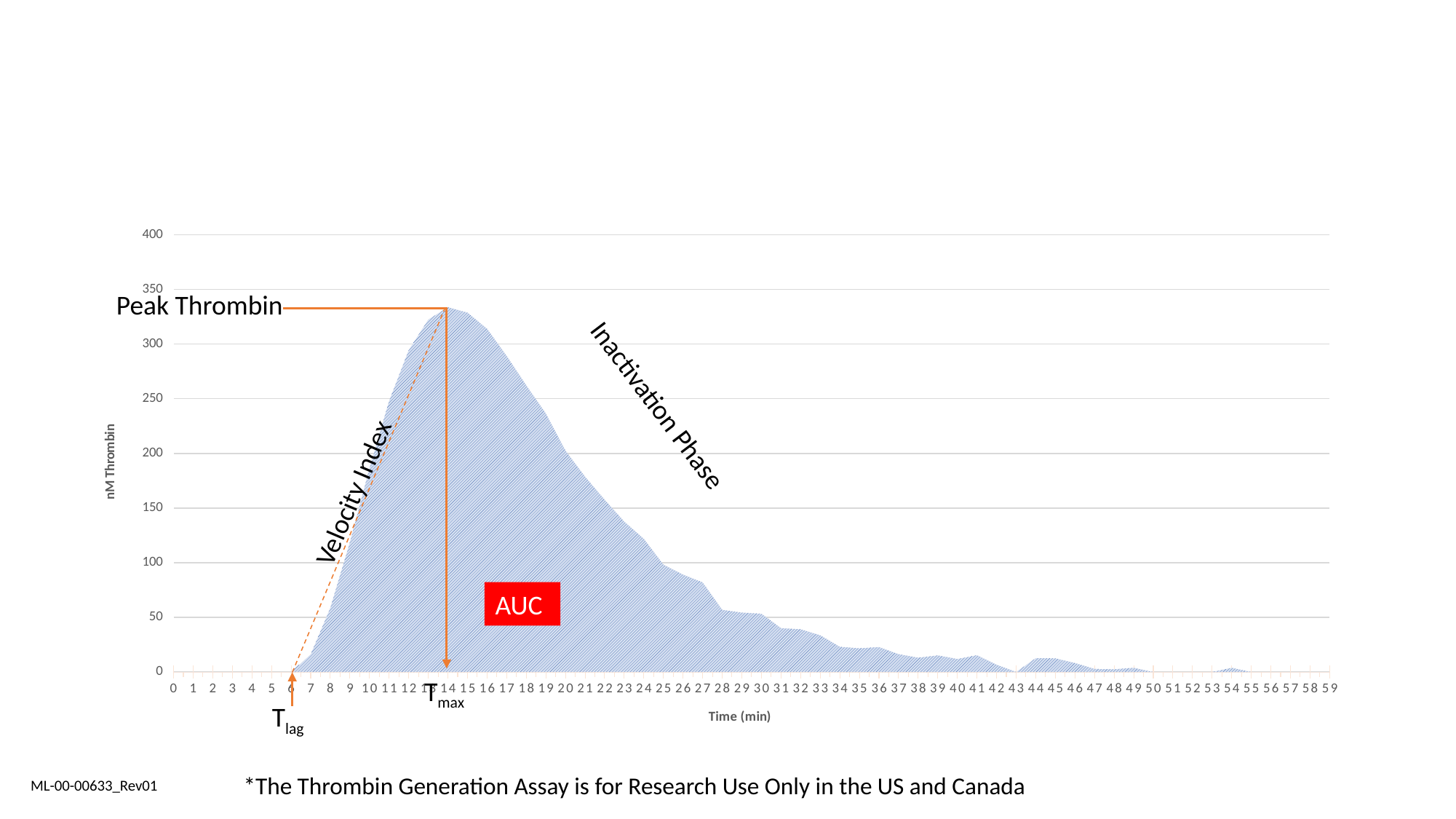
Is the value at 40 minutes greater or less than 50? less Is the peak thrombin value greater or less than 350? less Is the value at 5 minutes greater or less than 50? less Do the values rise or fall along the x axis between 14 and 30 minutes? fall What is the highest value shown on the y axis? 400 What is the label of the x axis? Time (min) At what time (in minutes) does the curve reach its highest value, as marked by Tmax? 14 What kind of chart is shown on the slide? area chart What is the label of the y axis? nM Thrombin